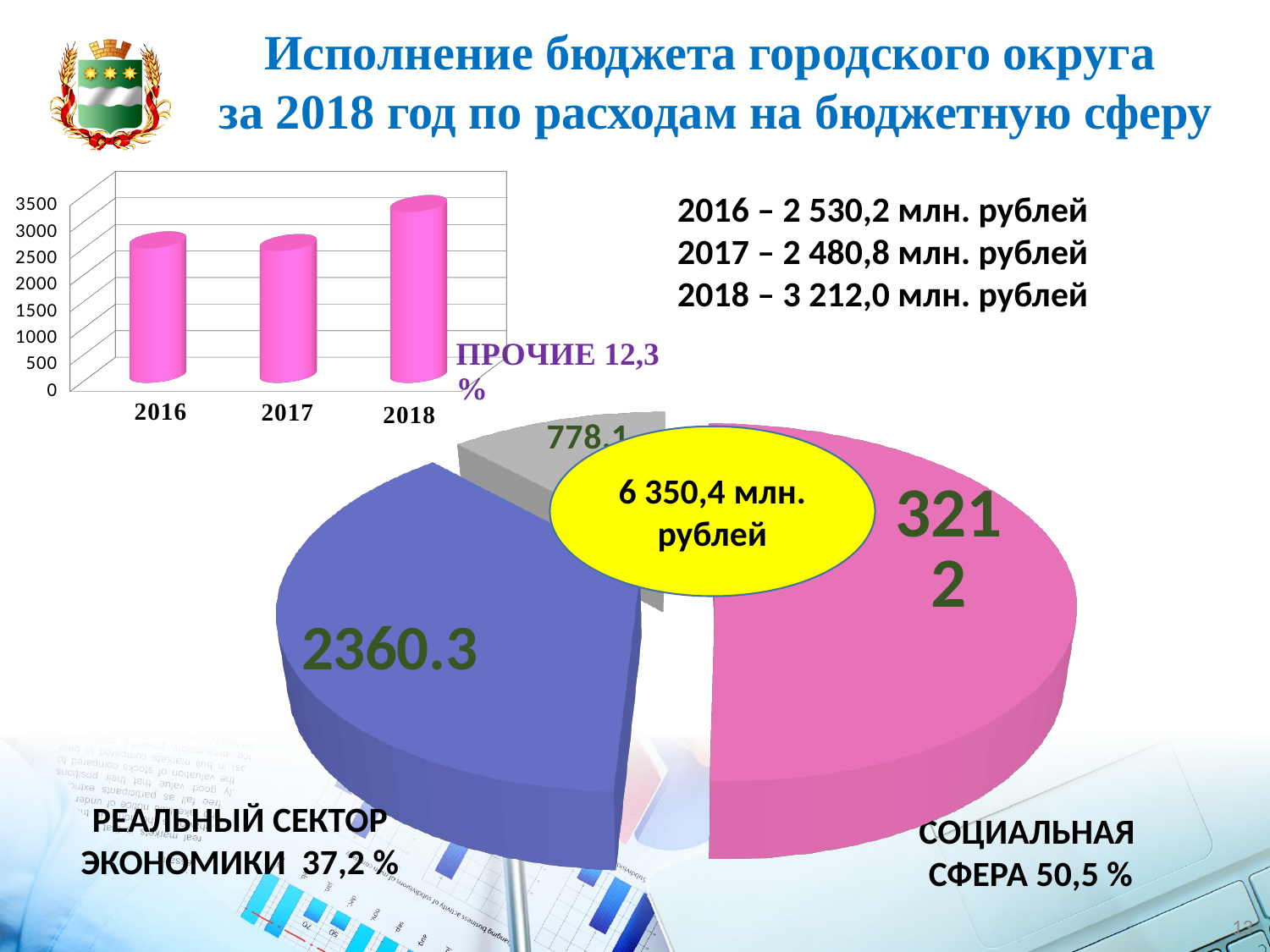
In the bar chart at the top left, which year has the highest value? 2018 In the bar chart at the top left, how many years are shown? 3 In the bar chart at the top left, is the value for 2017 greater or less than 3000? less In the pie chart, what share does СОЦИАЛЬНАЯ СФЕРА have? 50,5 % What kind of chart is shown at the top left of the slide? bar chart In the pie chart, what is the value for РЕАЛЬНЫЙ СЕКТОР ЭКОНОМИКИ? 2360.3 In the bar chart at the top left, which year has the lowest value? 2017 In the pie chart, what is the value for ПРОЧИЕ? 778.1 In the bar chart at the top left, what is the value for 2018? 3 212,0 млн. рублей In the bar chart at the top left, what is the value for 2017? 2 480,8 млн. рублей In the pie chart, what total is shown in the centre? 6 350,4 млн. рублей In the pie chart, which slice is the smallest? ПРОЧИЕ